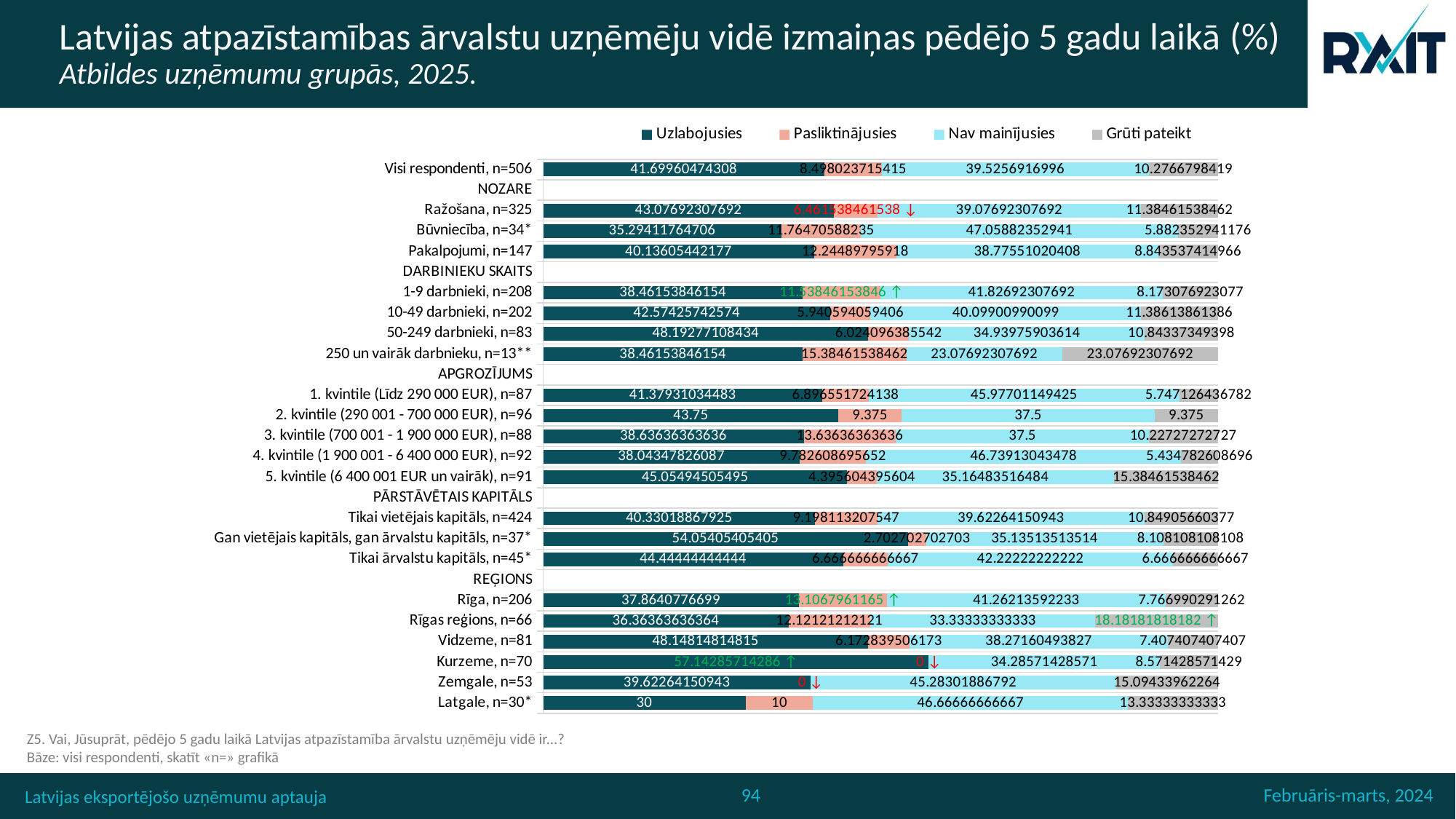
How many respondent groups (bars) are plotted in the chart? 22 Which is larger: the Uzlabojusies value for Gan vietējais kapitāls, gan ārvalstu kapitāls, n=37* or for Tikai vietējais kapitāls, n=424? Gan vietējais kapitāls, gan ārvalstu kapitāls, n=37* What is the total of the stacked bar for 2. kvintile (290 001 - 700 000 EUR), n=96? 100 What is the Pasliktinājusies value for Kurzeme, n=70? 0 What is the difference between the Uzlabojusies and Nav mainījusies values for 2. kvintile (290 001 - 700 000 EUR), n=96? 6.25 What kind of chart is shown on the slide? Stacked bar chart How many series does the legend list? 4 Which group has the lowest Uzlabojusies value? Latgale, n=30* What is the Grūti pateikt value for Rīgas reģions, n=66? 18.18181818182 Which group has the highest Uzlabojusies value? Kurzeme, n=70 What is the Uzlabojusies value for Visi respondenti, n=506? 41.69960474308 What is the Nav mainījusies value for Latgale, n=30*? 46.66666666667